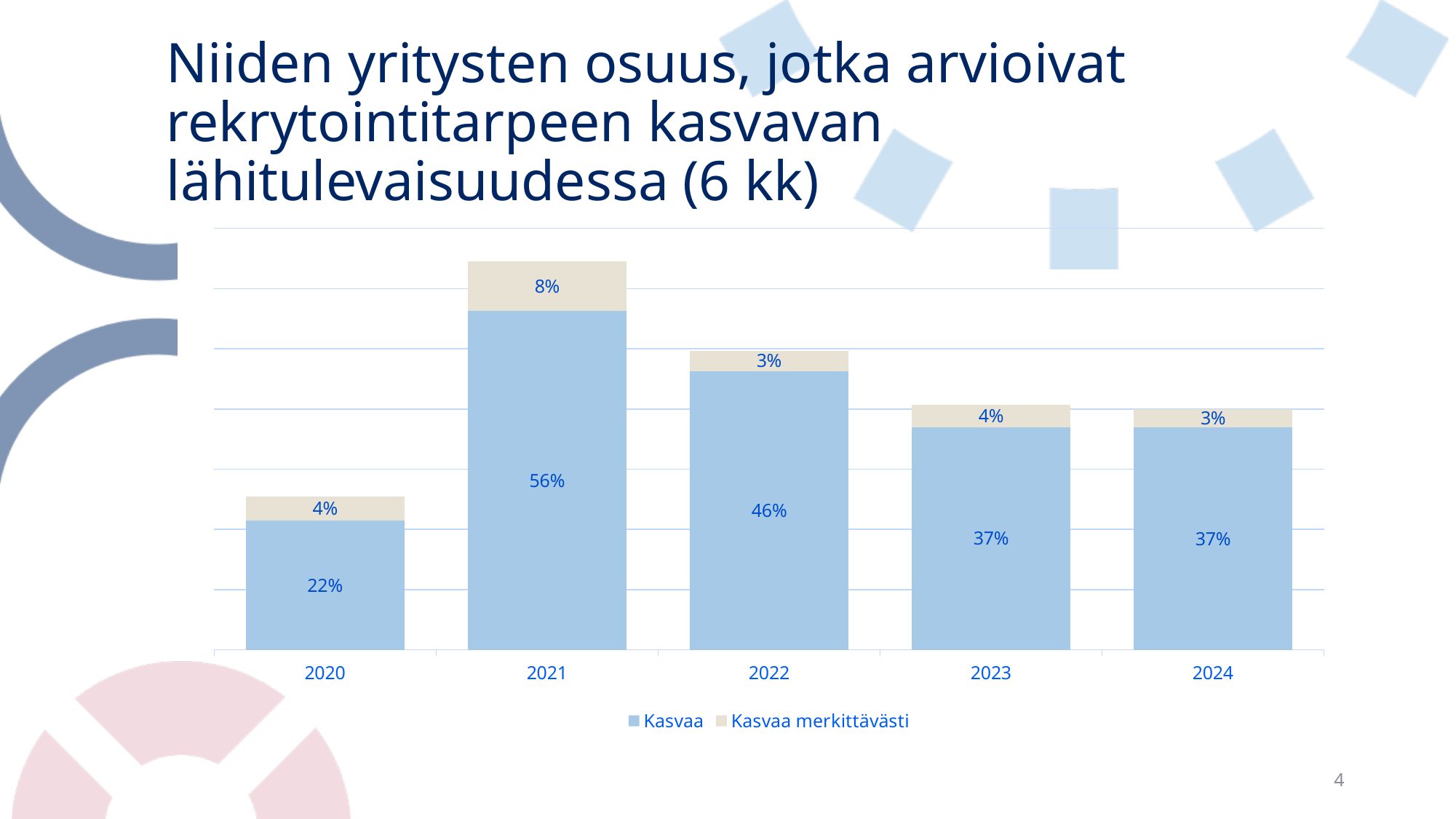
How many years are shown on the x axis? 5 What is the value for Kasvaa in 2021? 56% What kind of chart is shown on the slide? Stacked bar chart Which year has the highest value for Kasvaa? 2021 What is the difference between the Kasvaa values for 2021 and 2020? 34% Which year has the lowest value for Kasvaa? 2020 What is the value for Kasvaa merkittävästi in 2020? 4% Which is larger, the Kasvaa merkittävästi value for 2021 or for 2023? 2021 What is the value for Kasvaa in 2022? 46% What are the two legend entries of the chart? Kasvaa and Kasvaa merkittävästi How many series does the legend list? 2 What is the total of the stacked bar for 2021? 64%